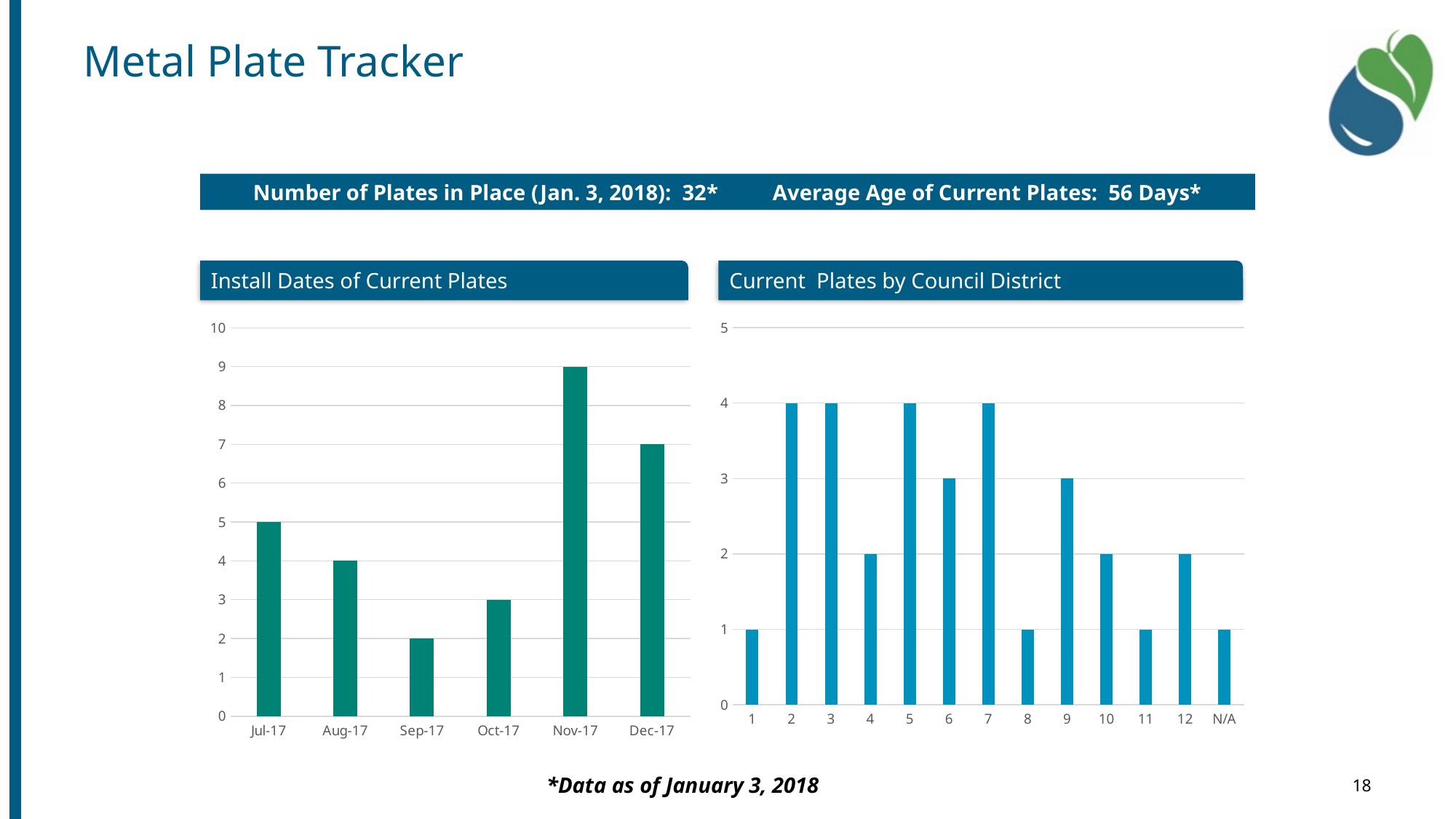
In the 'Current Plates by Council District' chart, what is the value for district 6? 3 In the 'Install Dates of Current Plates' chart, what is the value for Sep-17? 2 In the 'Current Plates by Council District' chart, how many categories are shown on the x axis? 13 In the 'Install Dates of Current Plates' chart, which month has the lowest value? Sep-17 In the 'Current Plates by Council District' chart, which is larger, the value for district 9 or the value for district 10? district 9 In the 'Install Dates of Current Plates' chart, is the value for Jul-17 greater or less than the value for Aug-17? greater What kind of chart is the 'Current Plates by Council District' chart? bar chart In the 'Install Dates of Current Plates' chart, which month has the highest value? Nov-17 In the 'Current Plates by Council District' chart, what is the value for N/A? 1 In the 'Install Dates of Current Plates' chart, what is the difference between the values for Nov-17 and Dec-17? 2 In the 'Install Dates of Current Plates' chart, how many months are shown on the x axis? 6 In the 'Install Dates of Current Plates' chart, what is the value for Nov-17? 9